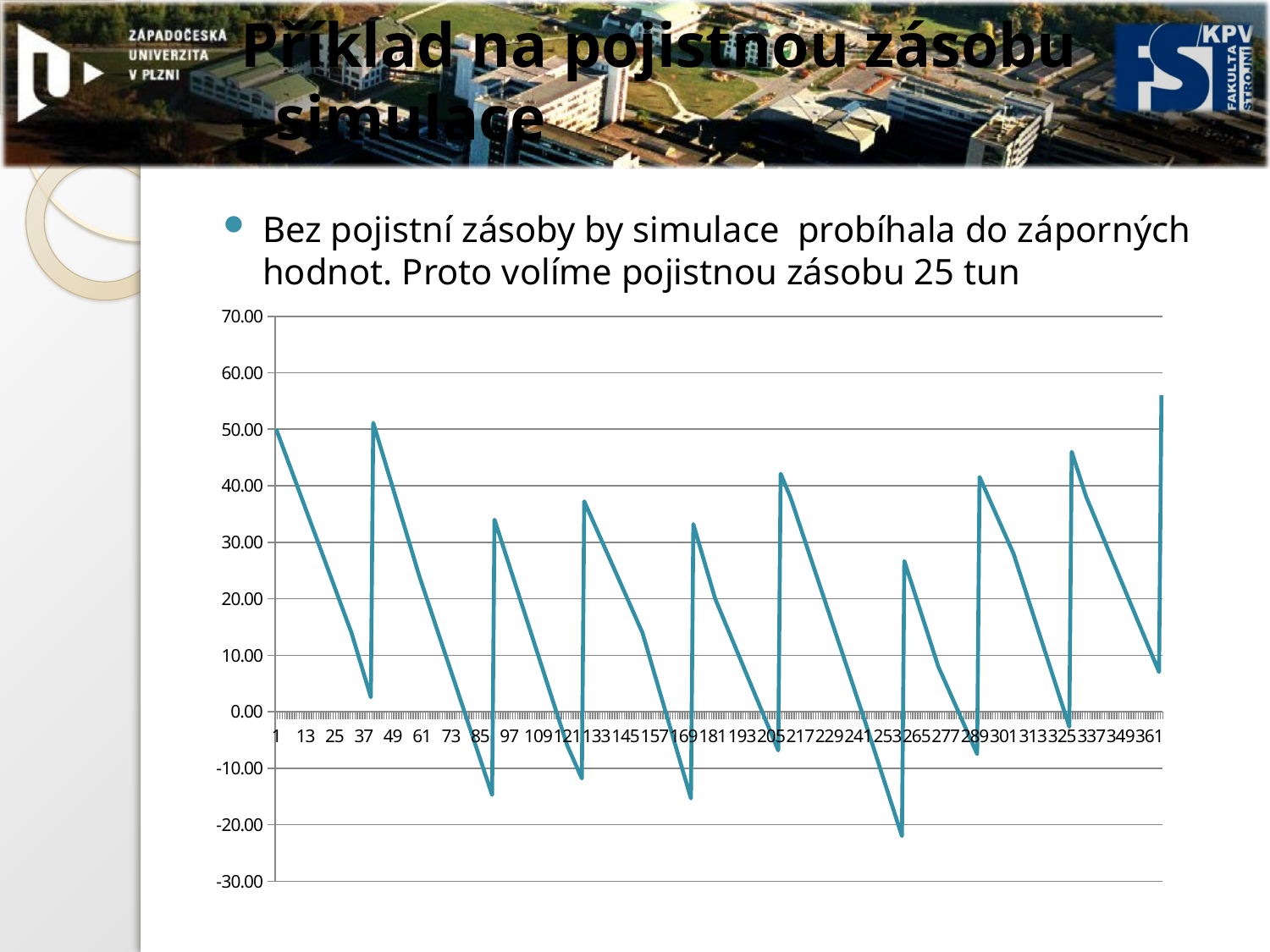
Is the value of the line at the final point (around x = 361) greater or less than 50.00? greater Is the peak of the line near x = 253 greater or less than 30.00? less What is the highest value shown on the vertical axis of the chart? 70.00 Is the lowest point of the line on the chart greater or less than -10.00? less What kind of chart is shown on the slide? line chart What is the last label shown on the horizontal axis of the chart? 361 How many data series are plotted on the chart? 1 Which is larger: the peak of the line near x = 37 or the peak near x = 253? the peak near x = 37 What is the lowest value shown on the vertical axis of the chart? -30.00